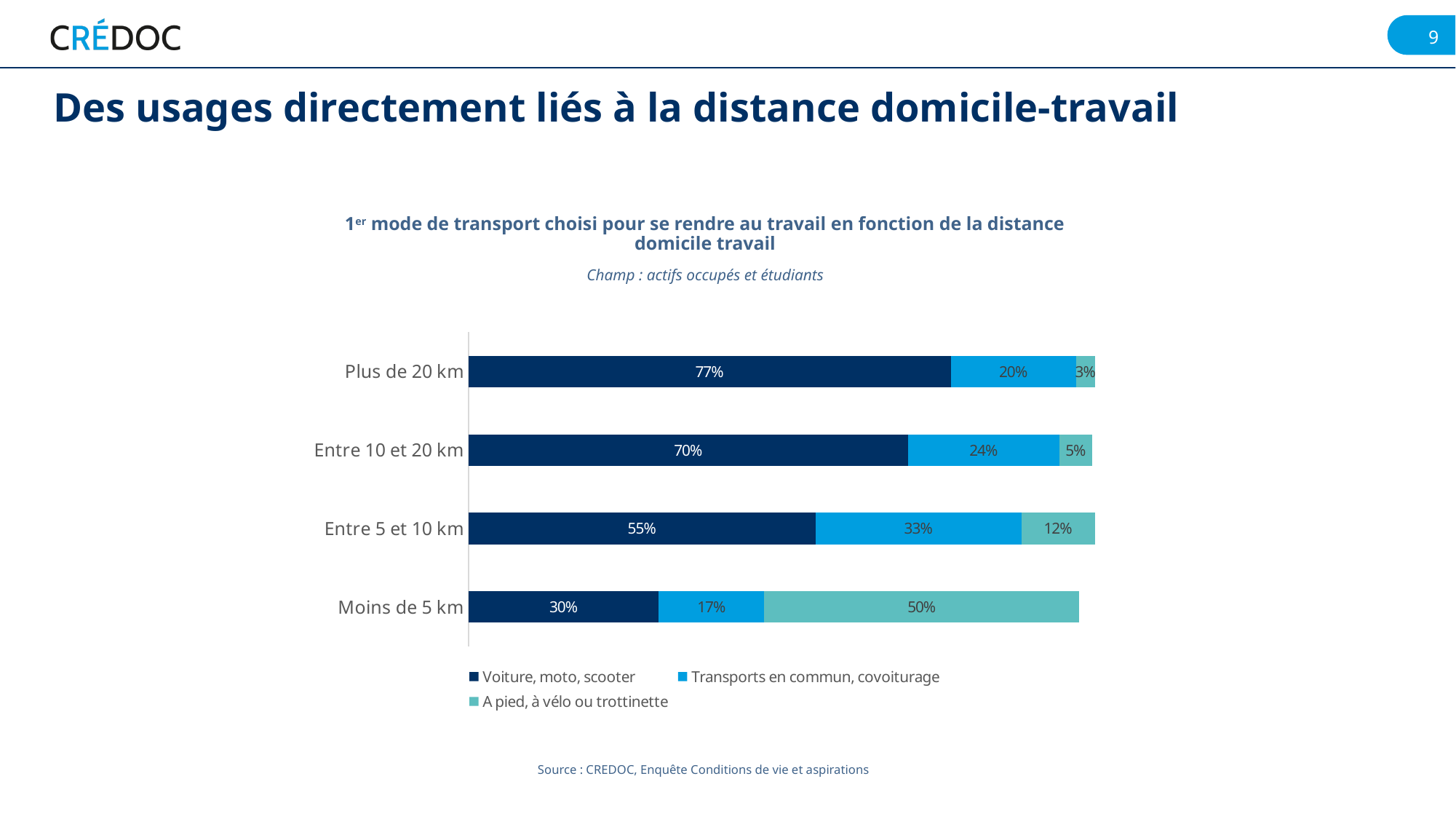
Which distance category has the lowest share for 'A pied, à vélo ou trottinette'? Plus de 20 km What is the value for 'Transports en commun, covoiturage' in the 'Entre 5 et 10 km' category? 33% What is the total of the stacked bar for 'Entre 5 et 10 km'? 100% Which distance category has the highest share for 'Voiture, moto, scooter'? Plus de 20 km What kind of chart is shown on the slide? Stacked bar chart How many series does the legend list? 3 How many distance categories are shown in the chart? 4 What is the difference between the 'Voiture, moto, scooter' shares for 'Plus de 20 km' and 'Moins de 5 km'? 47 percentage points What is the value for 'A pied, à vélo ou trottinette' in the 'Moins de 5 km' category? 50% Which is larger: 'Transports en commun, covoiturage' for 'Entre 10 et 20 km' or for 'Plus de 20 km'? Entre 10 et 20 km What share of people living more than 20 km from work choose 'Voiture, moto, scooter' as their first mode of transport? 77% What is the value for 'A pied, à vélo ou trottinette' in the 'Entre 10 et 20 km' category? 5%